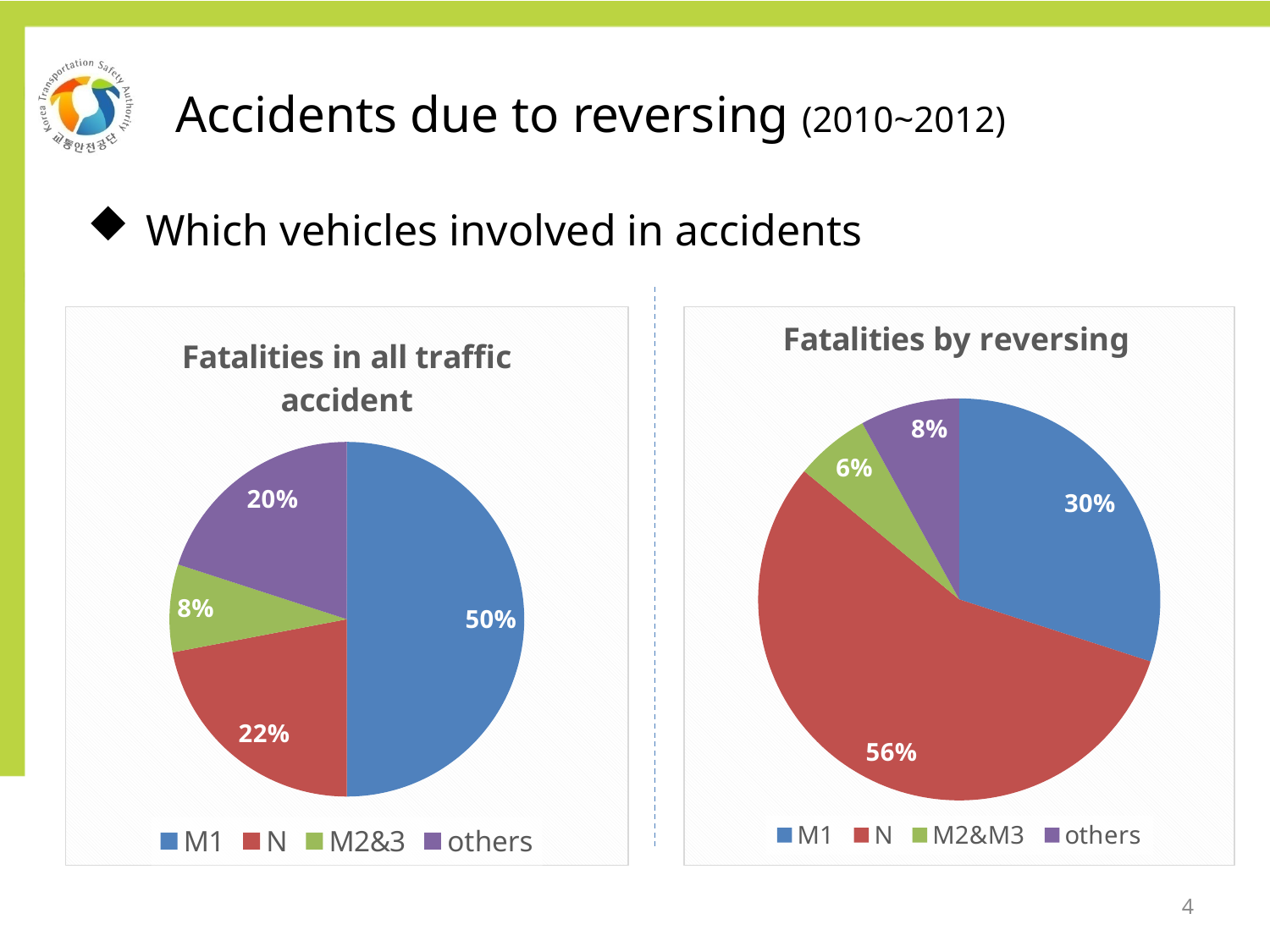
How many categories does the 'Fatalities by reversing' pie chart show? 4 In the 'Fatalities in all traffic accident' chart, which is larger, the share for N or the share for others? N What type of chart is 'Fatalities in all traffic accident'? Pie chart In the 'Fatalities by reversing' chart, what share does N have? 56% In the 'Fatalities by reversing' chart, which category has the largest slice? N In the 'Fatalities by reversing' chart, what is the difference between the N share and the M1 share? 26% In the 'Fatalities by reversing' chart, what share does others have? 8% In the 'Fatalities in all traffic accident' chart, which category has the largest slice? M1 In the 'Fatalities by reversing' chart, which category has the smallest slice? M2&M3 In the 'Fatalities in all traffic accident' chart, what share does M2&3 have? 8% What is the title of the chart on the right side of the slide? Fatalities by reversing